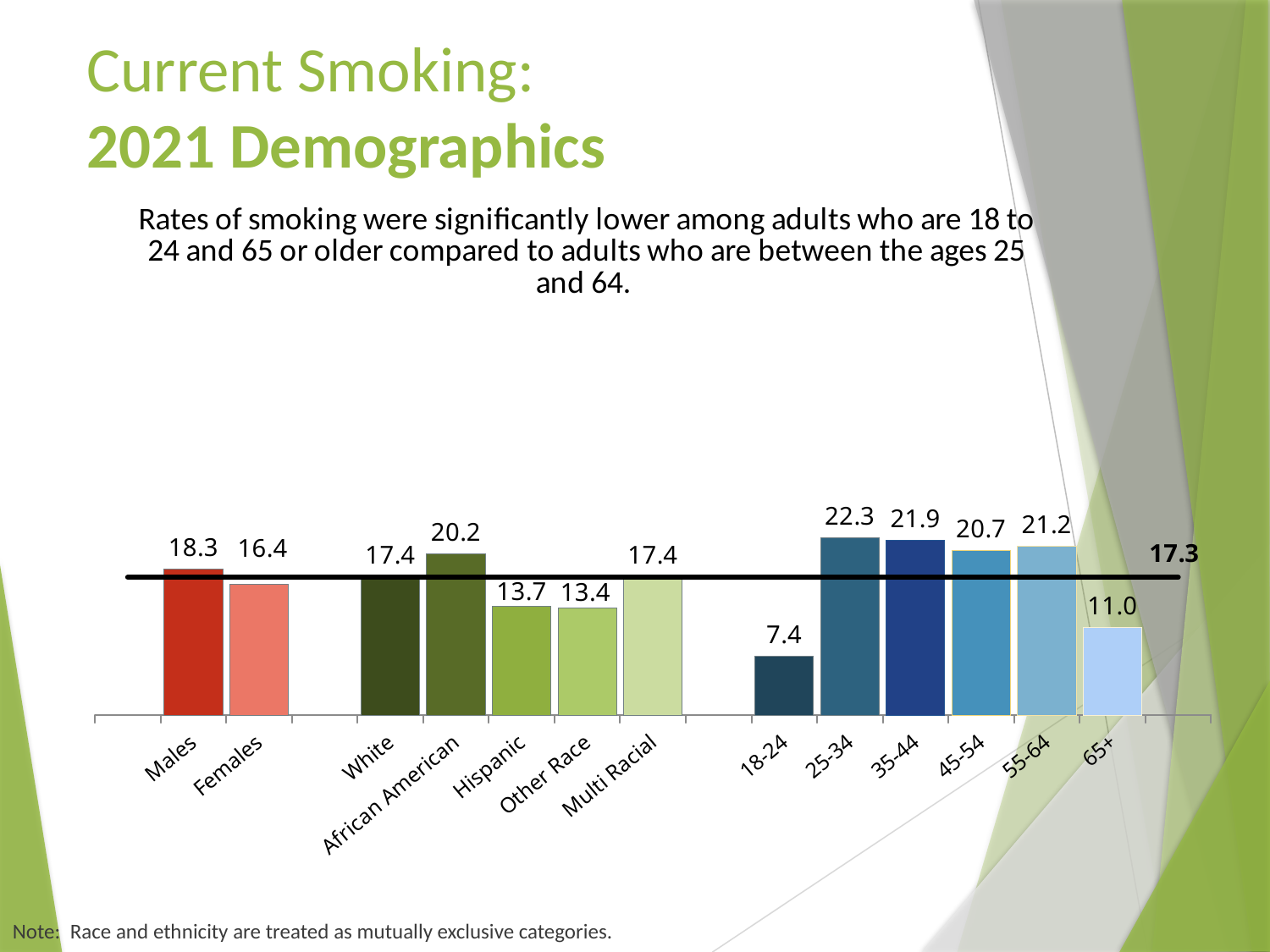
Which category has the lowest value on the chart? 18-24 What kind of chart is shown on the slide? Bar chart Which category has the highest value on the chart? 25-34 What is the current smoking rate shown for Males? 18.3 What is the difference between the values for the 25-34 and 65+ age groups? 11.3 What value does the horizontal black reference line across the chart represent? 17.3 What is the value shown for the 18-24 age group? 7.4 Which has a higher value, Hispanic or Other Race? Hispanic What is the difference between the values for Males and Females? 1.9 What is the value shown for African American? 20.2 How many bars are plotted on the chart? 13 What is the value shown for the 65+ age group? 11.0